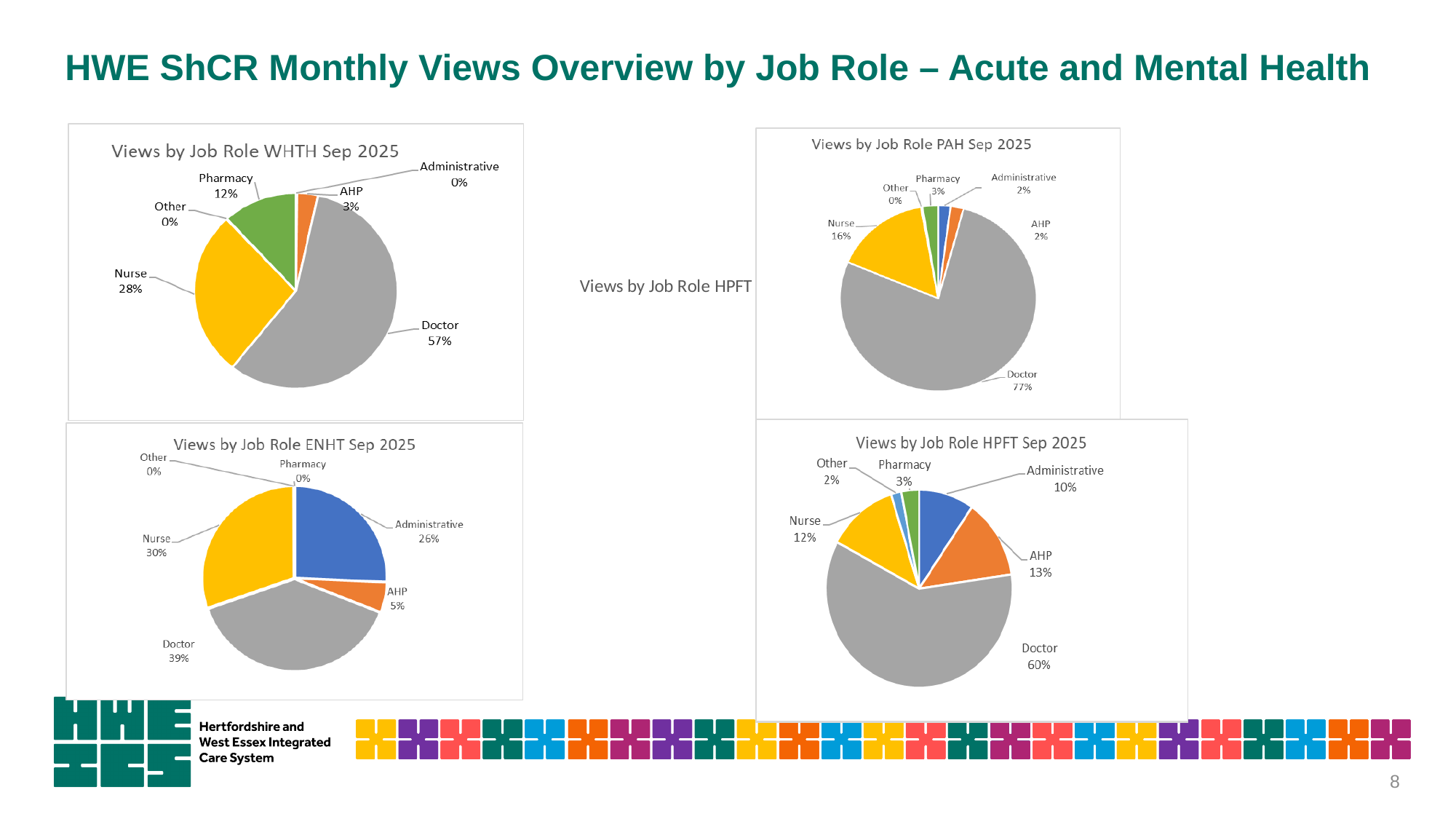
What type of chart is 'Views by Job Role WHTH Sep 2025'? Pie chart In the 'Views by Job Role HPFT Sep 2025' chart, what share of views is AHP? 13% In the 'Views by Job Role PAH Sep 2025' chart, what share of views is Nurse? 16% In the 'Views by Job Role WHTH Sep 2025' chart, what share of views is Doctor? 57% In the 'Views by Job Role PAH Sep 2025' chart, which job role has the largest share? Doctor In the 'Views by Job Role ENHT Sep 2025' chart, which is larger, Nurse or Doctor? Doctor How many pie charts are shown on the slide? 4 In the 'Views by Job Role HPFT Sep 2025' chart, what is the difference between the AHP and Nurse shares? 1% In the 'Views by Job Role ENHT Sep 2025' chart, what is the difference between the Doctor and Nurse shares? 9%